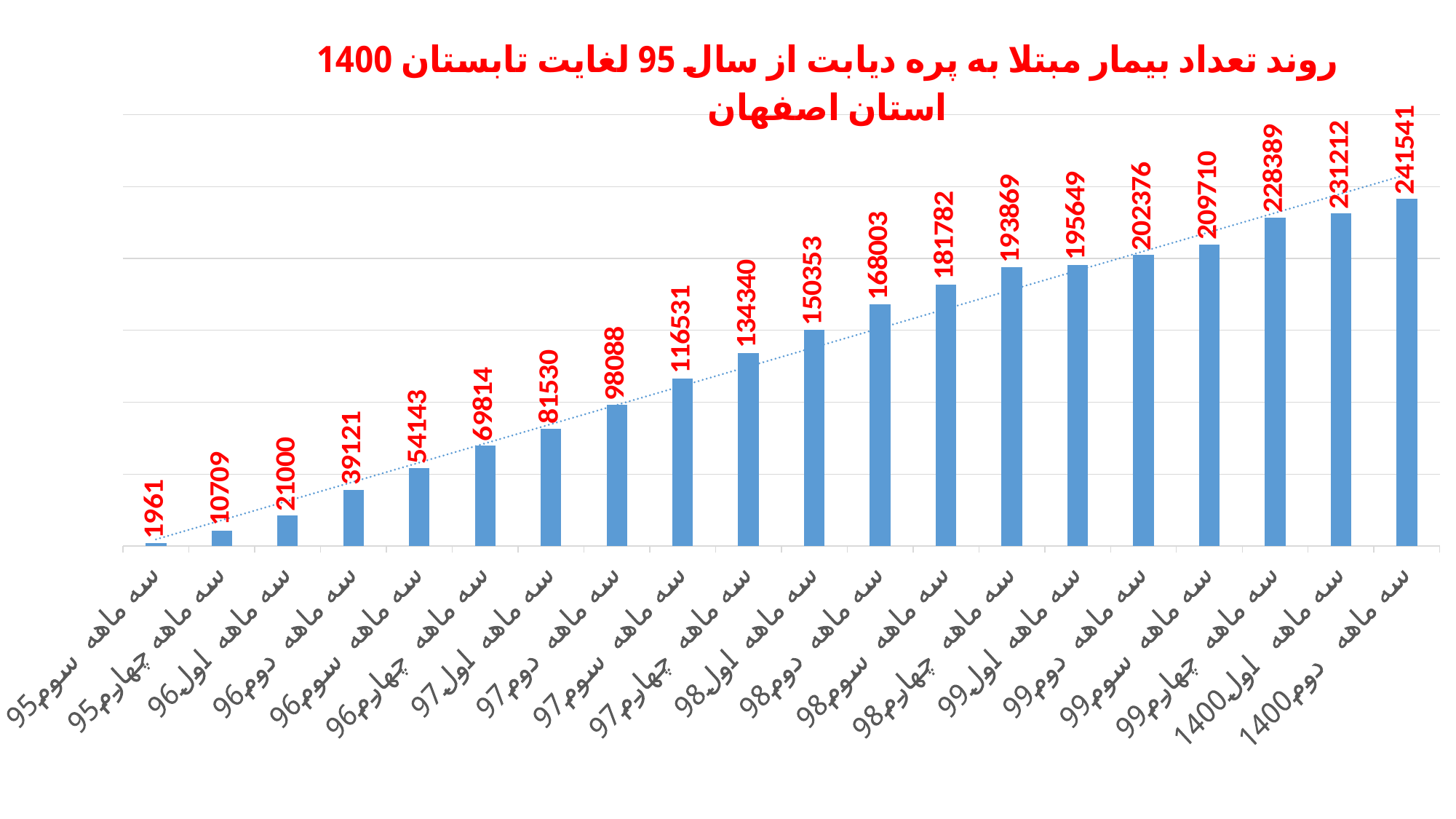
What is the value for سه ماهه دوم1400? 241541 How many categories are shown on the x axis? 20 Which category has the lowest value? سه ماهه سوم95 What is the value for سه ماهه اول97? 81530 What is the value for سه ماهه سوم95? 1961 What is the difference between the values for سه ماهه اول96 and سه ماهه چهارم95? 10291 Which is larger, the value for سه ماهه سوم97 or the value for سه ماهه اول98? سه ماهه اول98 Do the values rise or fall from left to right along the x axis? rise What is the difference between the values for سه ماهه دوم1400 and سه ماهه اول1400? 10329 What is the value for سه ماهه چهارم98? 193869 Which category has the highest value? سه ماهه دوم1400 What kind of chart is this? bar chart